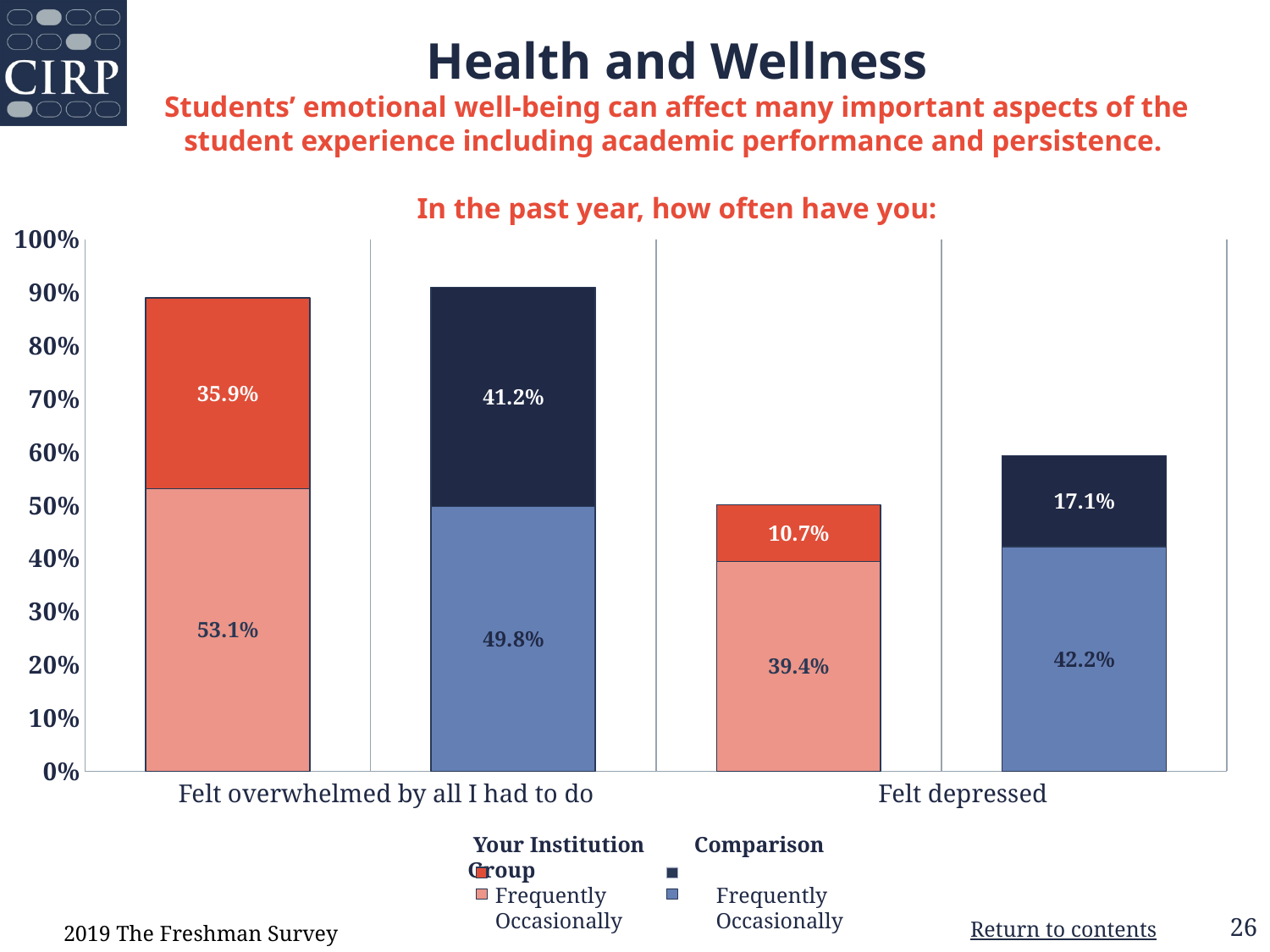
What percentage of the Comparison Group reported occasionally feeling depressed? 42.2% What percentage of students at Your Institution reported occasionally feeling overwhelmed by all they had to do? 53.1% How many entries does the chart legend list? 4 What is the total percentage (frequently plus occasionally) of Your Institution students who felt depressed? 50.1% What is the total percentage (frequently plus occasionally) of the Comparison Group who felt overwhelmed by all they had to do? 91.0% What percentage of the Comparison Group reported frequently feeling depressed? 17.1% What is the difference between the Comparison Group and Your Institution in the percentage who frequently felt overwhelmed by all they had to do? 5.3% What percentage of students at Your Institution reported frequently feeling overwhelmed by all they had to do? 35.9% Which of the two survey items has the lowest 'Frequently' percentage for Your Institution? Felt depressed How many survey items (categories) are shown on the x axis of the chart? 2 What type of chart is shown on the slide? Stacked bar chart Which group has a higher percentage of students who frequently felt depressed, Your Institution or the Comparison Group? Comparison Group